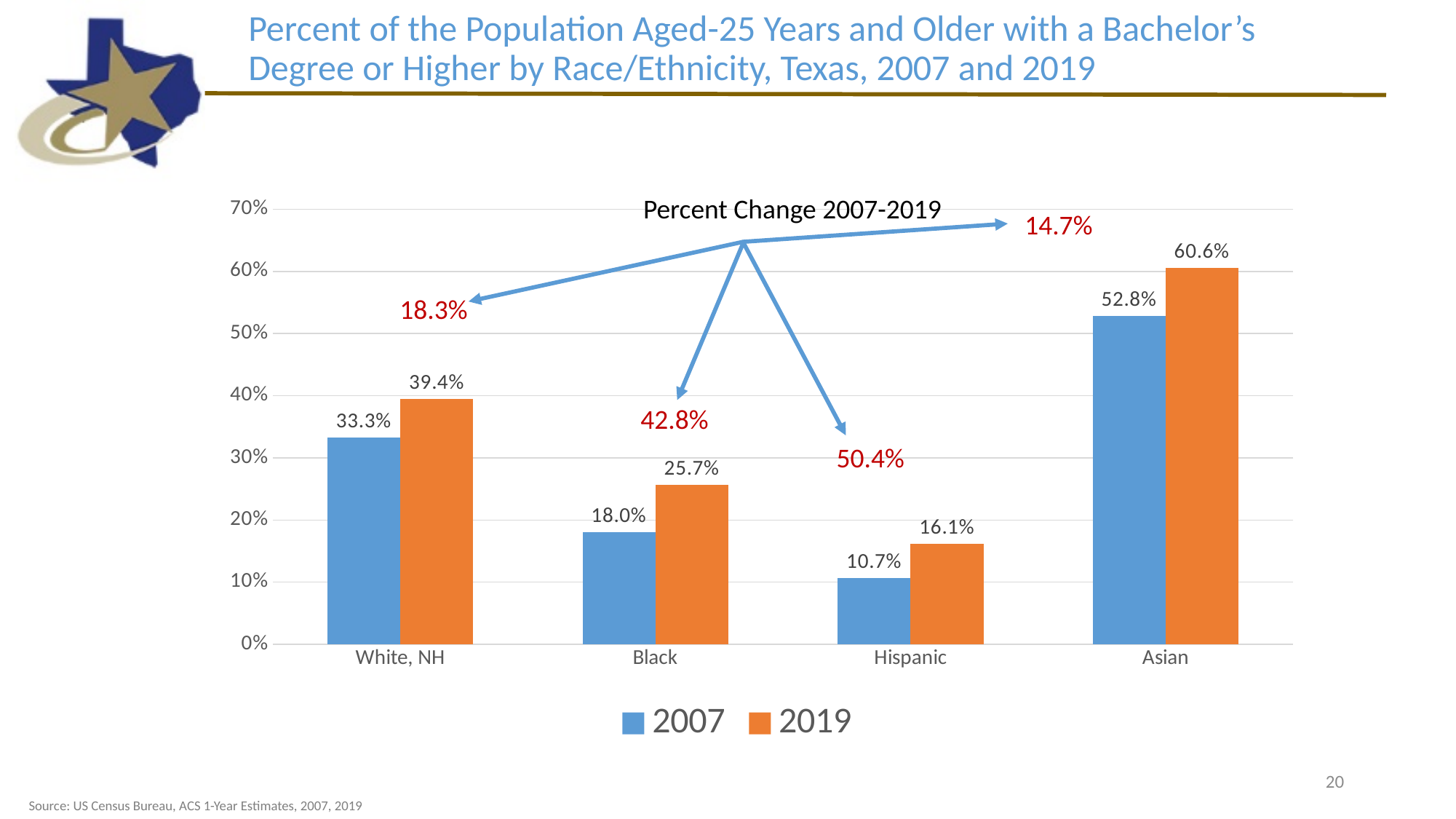
What was the percent of the population aged 25 and older with a bachelor's degree or higher for Asian in 2019? 60.6% What kind of chart is shown on the slide? Bar chart How many series does the legend list? 2 Which colour represents the 2019 series in the legend? Orange What was the value for Hispanic in 2007? 10.7% Which is larger: the 2019 value for Black or the 2007 value for White, NH? 2007 value for White, NH What is the percent change from 2007 to 2019 annotated for Hispanic? 50.4% Which race/ethnicity group had the highest value in 2019? Asian What is the difference between the 2019 and 2007 values for White, NH? 6.1% Which race/ethnicity group had the lowest value in 2007? Hispanic How many race/ethnicity categories are shown on the x axis? 4 What was the value for Black in 2019? 25.7%